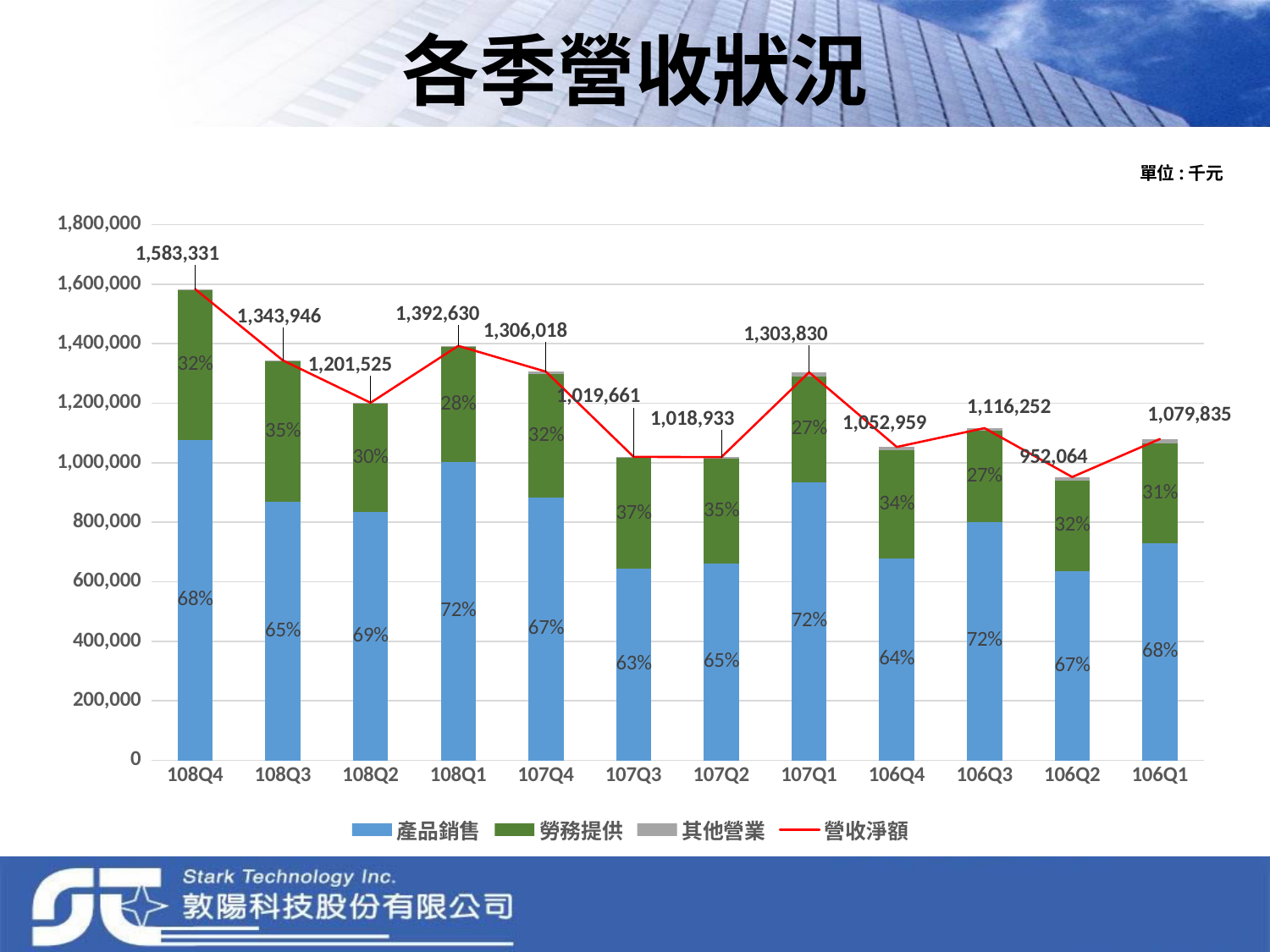
How many quarters are shown on the x axis? 12 What is the 營收淨額 value for 106Q2? 952,064 What unit is stated for the values in the chart? 千元 Which quarter has a larger 營收淨額, 108Q1 or 107Q4? 108Q1 What percentage does 勞務提供 account for in 108Q1? 28% What is the 營收淨額 value for 108Q4? 1,583,331 Which quarter has the lowest 營收淨額? 106Q2 What percentage does 產品銷售 account for in 107Q3? 63% How many series does the legend list? 4 Is the 營收淨額 for 106Q2 greater or less than 1,000,000? less Which quarter has the highest 營收淨額? 108Q4 What is the difference in 營收淨額 between 108Q4 and 108Q3? 239,385